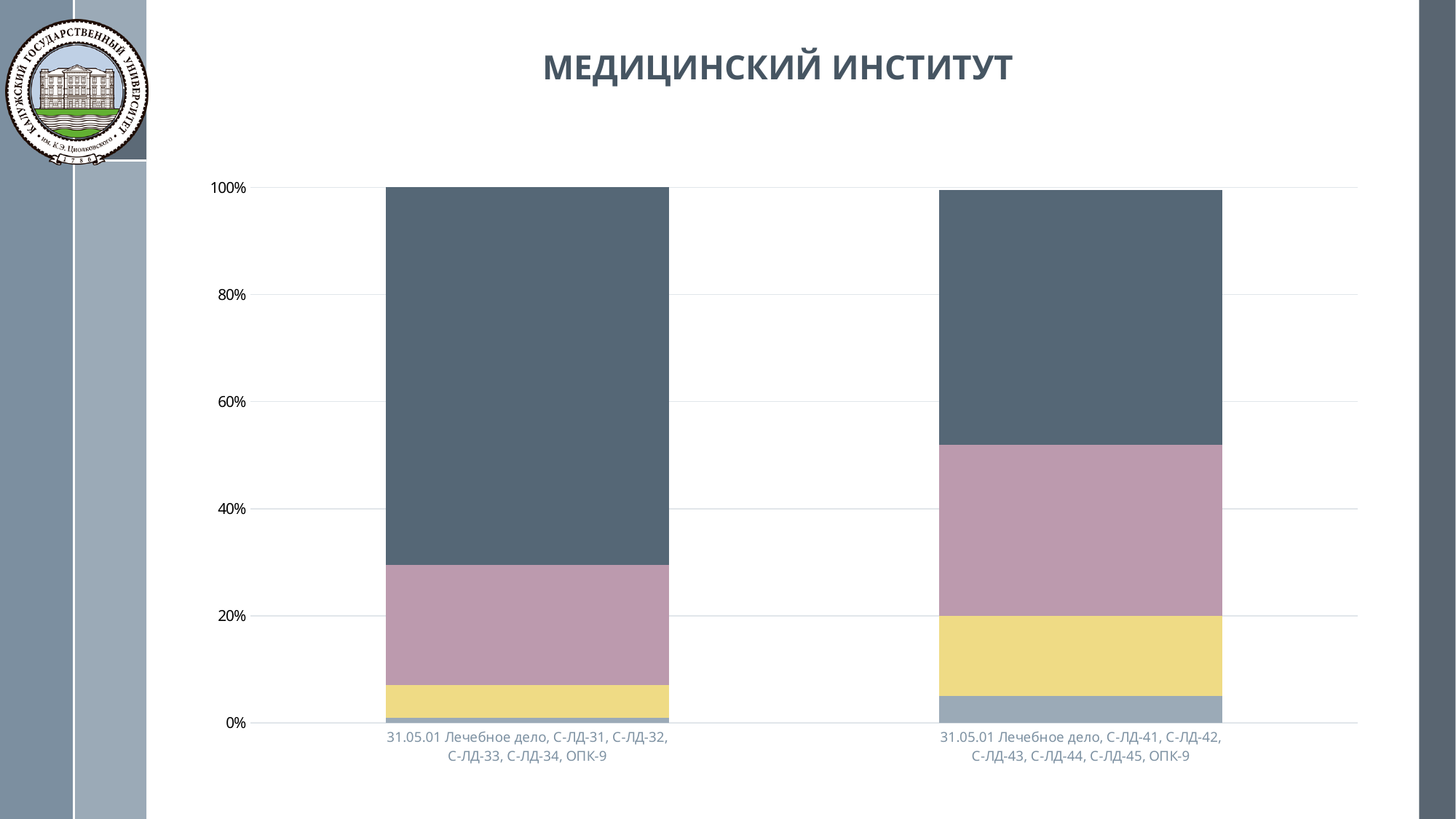
Which bar has the larger pink segment: the one for С-ЛД-31–С-ЛД-34 or the one for С-ЛД-41–С-ЛД-45? С-ЛД-41, С-ЛД-42, С-ЛД-43, С-ЛД-44, С-ЛД-45 What kind of chart is shown on the slide? stacked bar chart Is the yellow segment of the bar for С-ЛД-31, С-ЛД-32, С-ЛД-33, С-ЛД-34 greater or less than 10%? less Which bar has the larger dark grey-blue top segment: the one for С-ЛД-31–С-ЛД-34 or the one for С-ЛД-41–С-ЛД-45? С-ЛД-31, С-ЛД-32, С-ЛД-33, С-ЛД-34 Is the pink segment of the bar for С-ЛД-41, С-ЛД-42, С-ЛД-43, С-ЛД-44, С-ЛД-45 greater or less than 20%? greater Which bar has the larger yellow segment: the one for С-ЛД-31–С-ЛД-34 or the one for С-ЛД-41–С-ЛД-45? С-ЛД-41, С-ЛД-42, С-ЛД-43, С-ЛД-44, С-ЛД-45 Is the dark grey-blue top segment of the bar for С-ЛД-31, С-ЛД-32, С-ЛД-33, С-ЛД-34 greater or less than 60% of the bar? greater How many bars (categories) does the chart show? 2 How many coloured segments make up each stacked bar? 4 What is the title of the slide above the chart? МЕДИЦИНСКИЙ ИНСТИТУТ